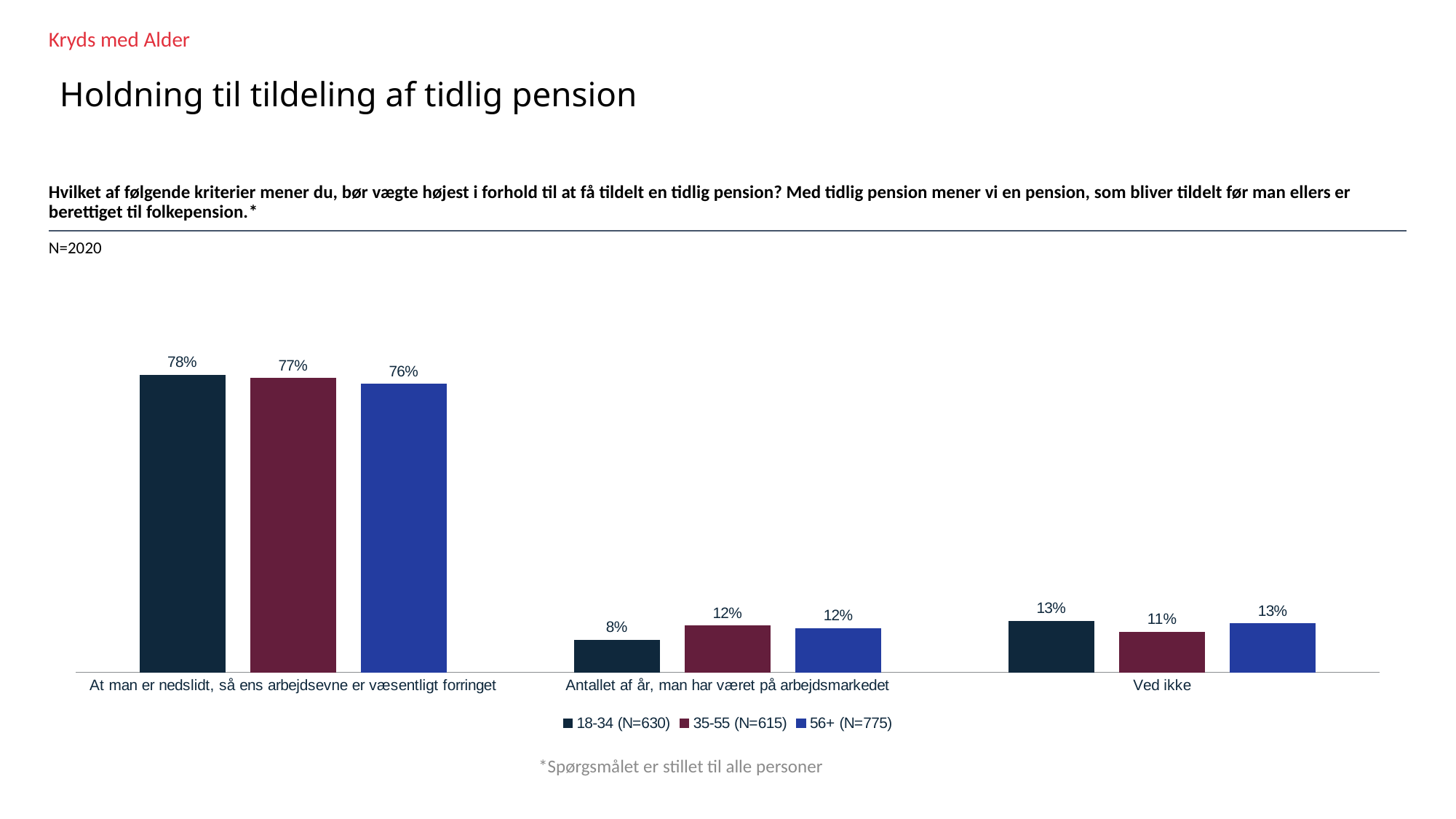
Which category has the lowest value for the 18-34 (N=630) series? Antallet af år, man har været på arbejdsmarkedet How many series does the legend list? 3 What is the value for the 56+ (N=775) series in the category "Ved ikke"? 13% How many categories are shown on the x axis? 3 What is the difference between the 35-55 (N=615) and 18-34 (N=630) values in the category "Antallet af år, man har været på arbejdsmarkedet"? 4% What kind of chart is shown on the slide? Bar chart What is the value for the 35-55 (N=615) series in the category "Antallet af år, man har været på arbejdsmarkedet"? 12% What is the difference between the 18-34 (N=630) and 56+ (N=775) values in the category "At man er nedslidt, så ens arbejdsevne er væsentligt forringet"? 2% What is the value for the 18-34 (N=630) series in the category "At man er nedslidt, så ens arbejdsevne er væsentligt forringet"? 78% What is the value for the 18-34 (N=630) series in the category "Antallet af år, man har været på arbejdsmarkedet"? 8% Which category has the highest value for the 56+ (N=775) series? At man er nedslidt, så ens arbejdsevne er væsentligt forringet In the category "Ved ikke", which series has the larger value: 18-34 (N=630) or 35-55 (N=615)? 18-34 (N=630)